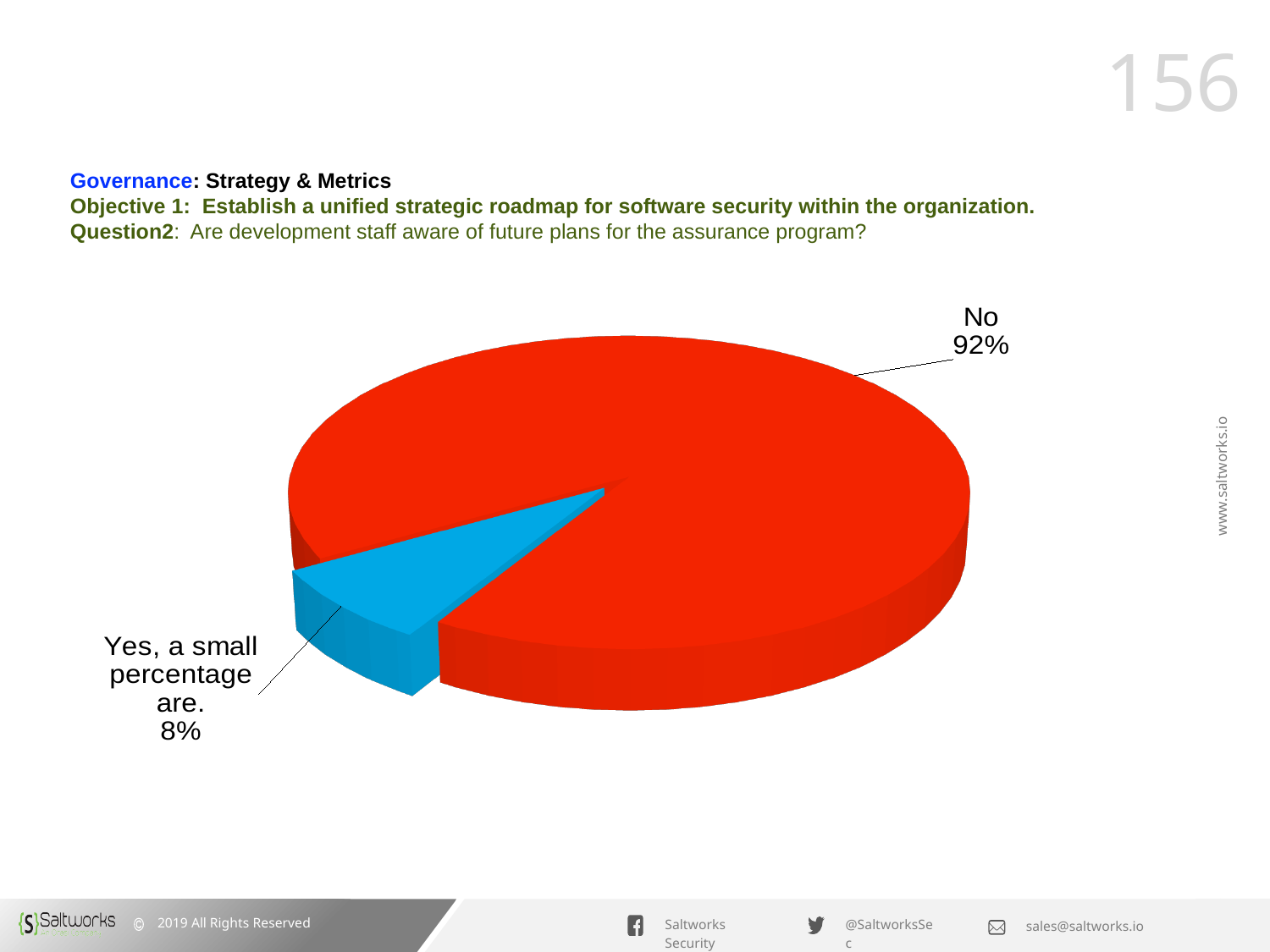
Is the value for the "No" slice greater or less than 50%? greater What percentage of the pie is labelled "Yes, a small percentage are."? 8% What share of the pie does the "No" slice represent? 92% What is the difference in percentage points between the "No" slice and the "Yes, a small percentage are." slice? 84 What kind of chart is shown on the slide? Pie chart What percentage of the pie is labelled "No"? 92% Which is larger, the "No" slice or the "Yes, a small percentage are." slice? No How many slices does the pie chart have? 2 What colour is the "No" slice of the pie? Red Which slice of the pie is the largest? No Which slice of the pie is the smallest? Yes, a small percentage are. What colour is the "Yes, a small percentage are." slice of the pie? Blue